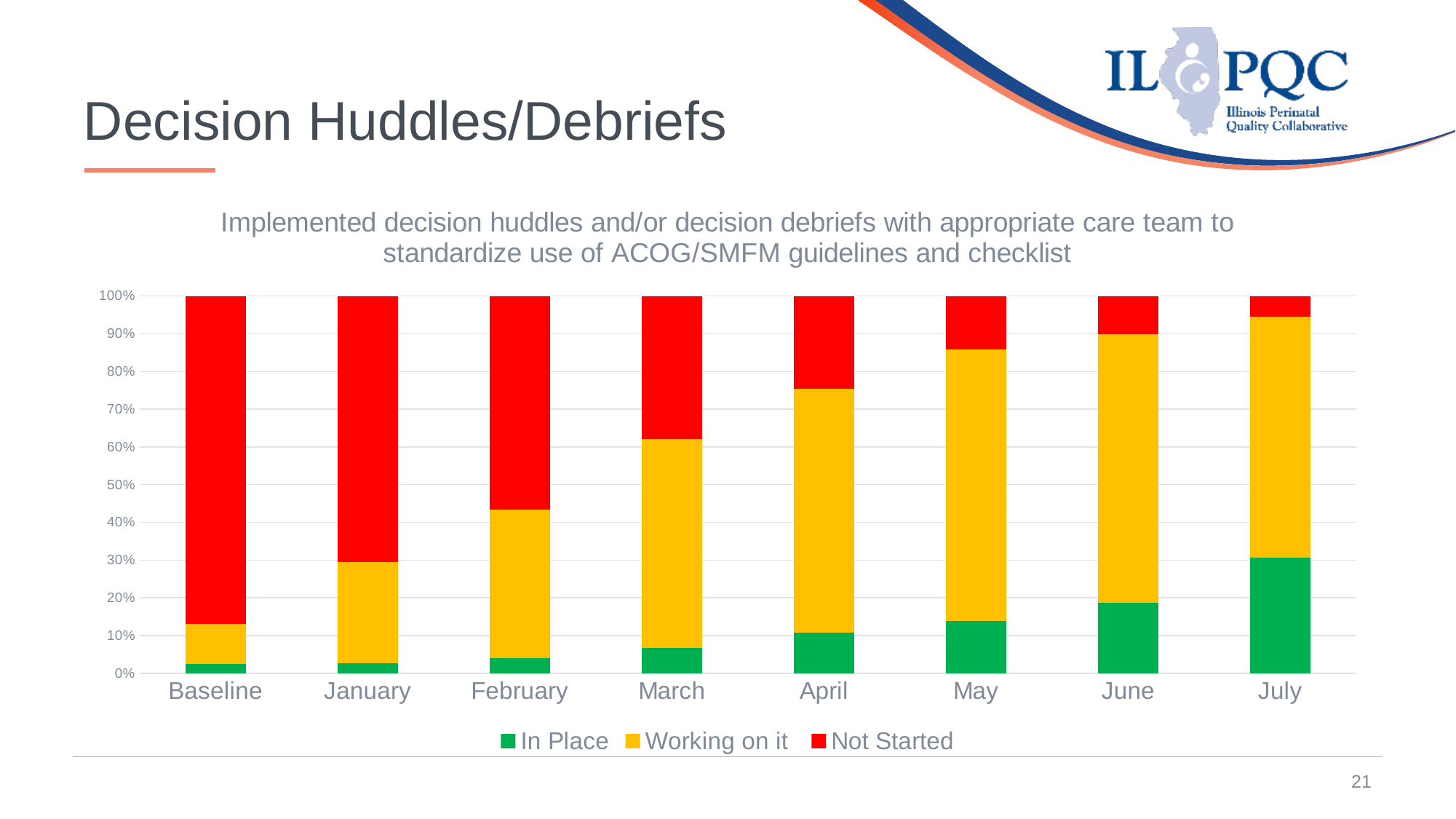
Is the 'In Place' share for June greater or less than 10%? greater Is the 'Not Started' share for Baseline greater or less than 80%? greater How many series does the legend list? 3 Which is larger, the 'In Place' share for March or for June? June Does the 'In Place' share rise or fall from Baseline to July? rise Is the 'Working on it' share for January greater or less than 40%? less Which category has the smallest 'Not Started' share? July How many categories are shown along the x axis? 8 Which category has the largest 'In Place' share? July What colour represents 'Not Started' in the legend? Red What kind of chart is shown on the slide? Stacked bar chart Which category has the largest 'Not Started' share? Baseline